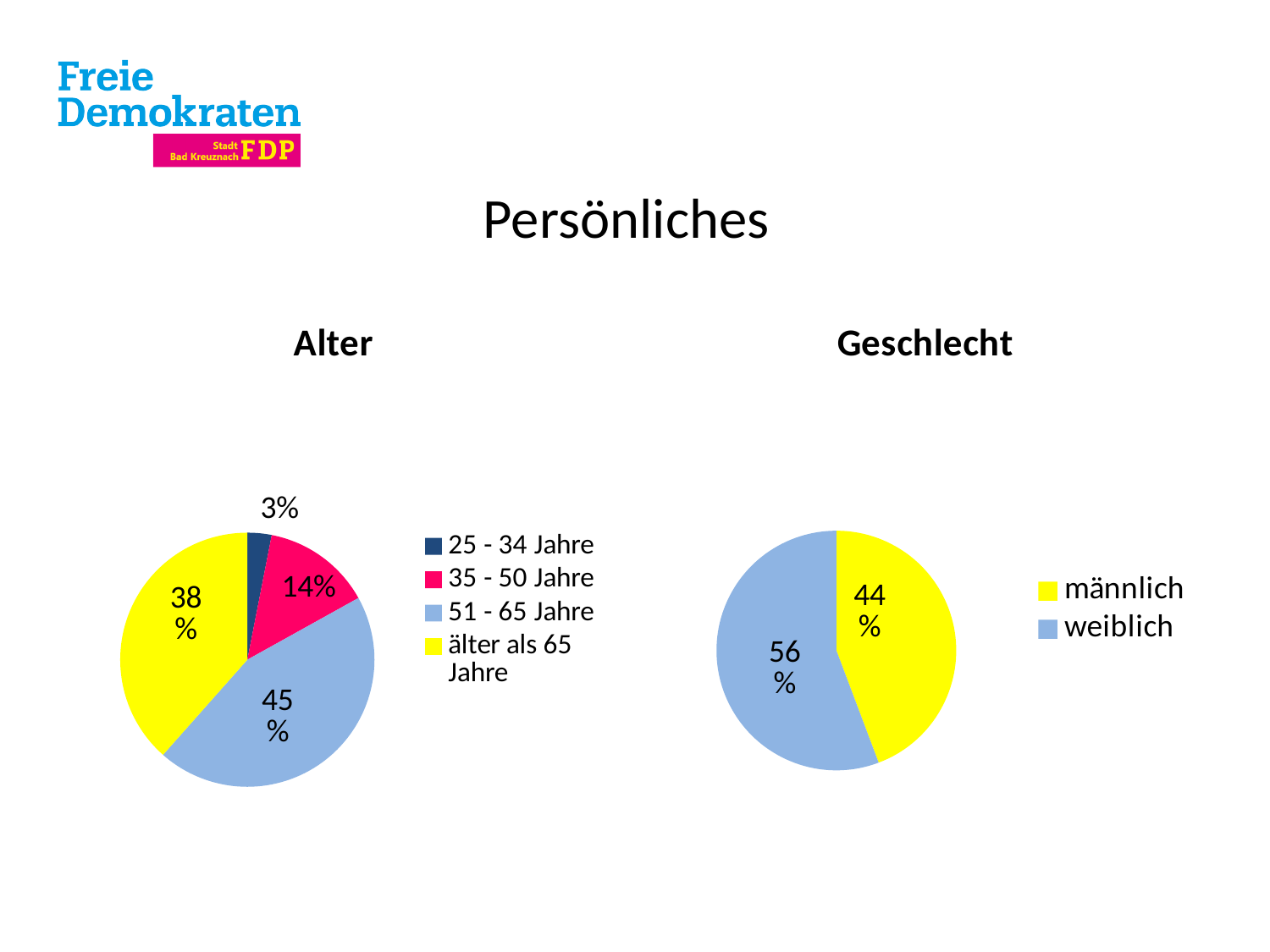
In the 'Geschlecht' chart, what share is shown for 'weiblich'? 56% In the 'Alter' chart, what share is shown for '51 - 65 Jahre'? 45% In the 'Geschlecht' chart, how many entries does the legend list? 2 In the 'Alter' chart, how many age groups are shown? 4 In the 'Alter' chart, what share is shown for 'älter als 65 Jahre'? 38% What kind of chart is the 'Geschlecht' chart? Pie chart In the 'Alter' chart, which age group has the largest share? 51 - 65 Jahre In the 'Alter' chart, what is the difference between the shares for '51 - 65 Jahre' and '35 - 50 Jahre'? 31% In the 'Alter' chart, what share is shown for '25 - 34 Jahre'? 3% In the 'Alter' chart, which age group has the smallest share? 25 - 34 Jahre In the 'Geschlecht' chart, which is larger, 'männlich' or 'weiblich'? weiblich In the 'Geschlecht' chart, what is the difference between the shares for 'weiblich' and 'männlich'? 12%